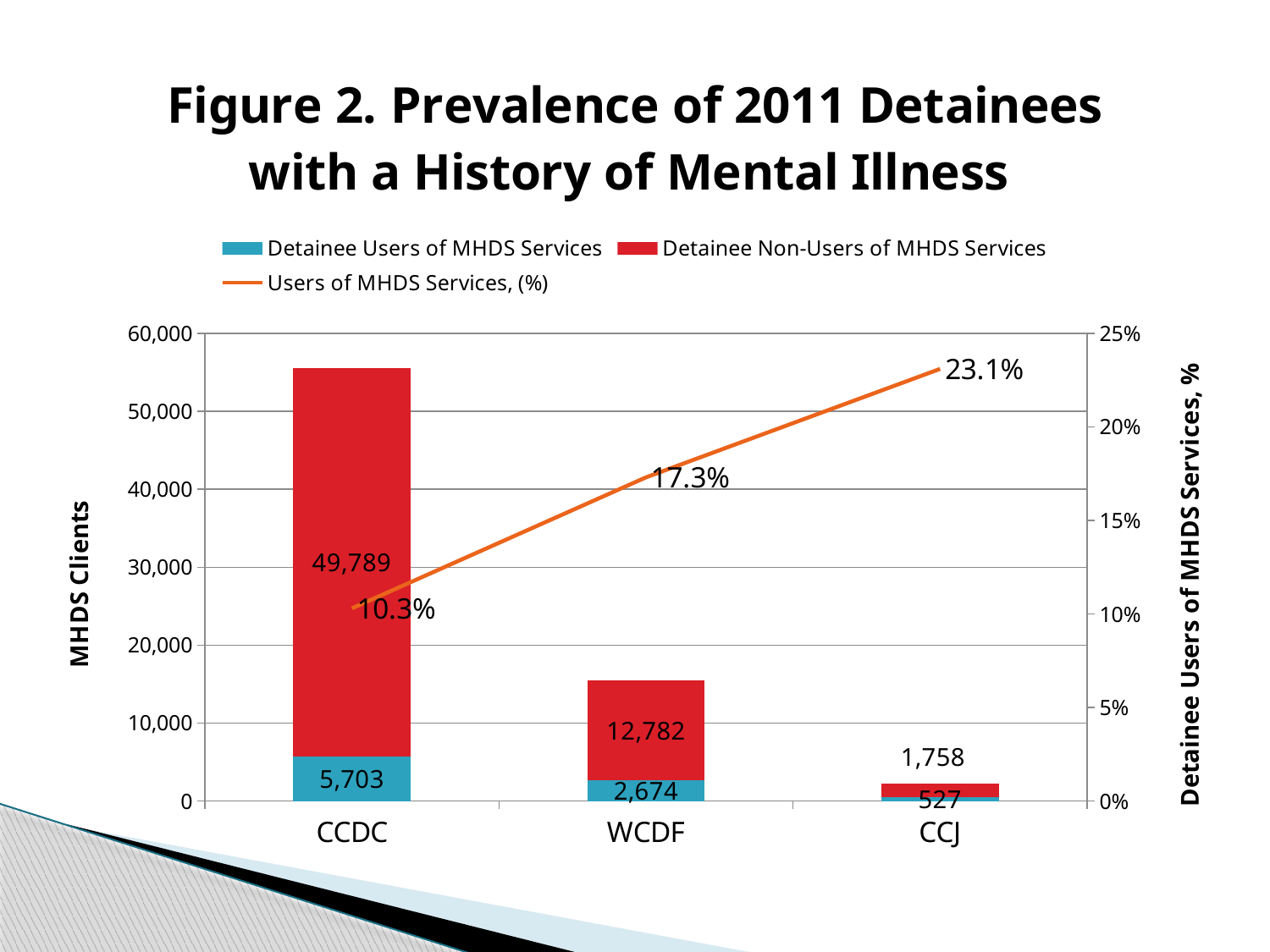
Which facility has the lowest percentage of Users of MHDS Services? CCDC What is the total height of the stacked bar for WCDF (users plus non-users)? 15,456 How many facilities are shown on the x axis? 3 Is the number of Detainee Users of MHDS Services larger at WCDF or at CCJ? WCDF What is the value for Detainee Non-Users of MHDS Services at WCDF? 12,782 Does the Users of MHDS Services (%) line rise or fall from CCDC to CCJ? rise What is the difference between Detainee Users of MHDS Services at CCDC and at WCDF? 3,029 What percentage of detainees at CCJ are Users of MHDS Services? 23.1% What is the value for Detainee Users of MHDS Services at CCDC? 5,703 How many series does the legend list? 3 Which facility has the highest number of Detainee Non-Users of MHDS Services? CCDC What is the value for Detainee Non-Users of MHDS Services at CCJ? 1,758